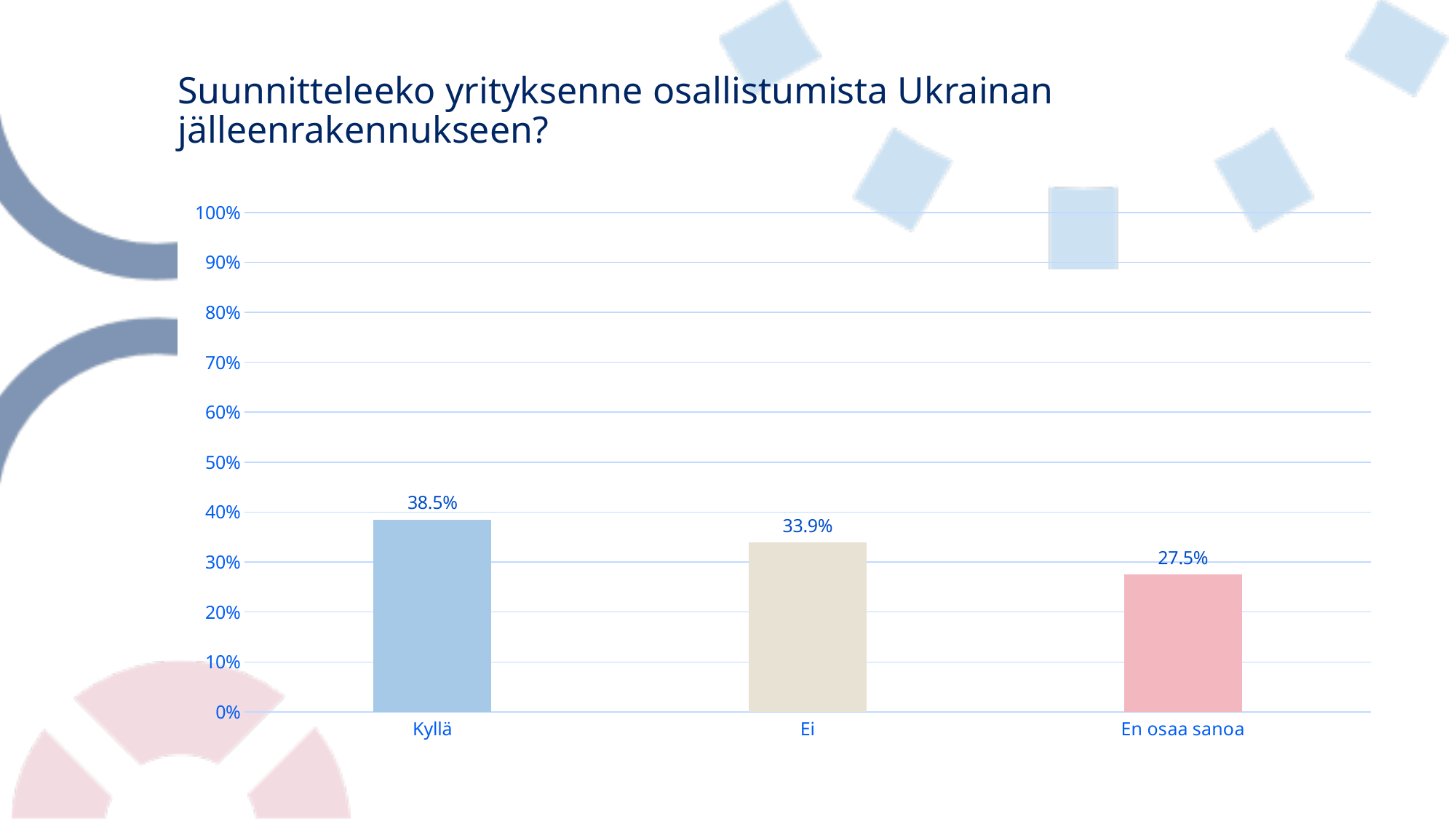
Which category has the highest value? Kyllä What is the difference between the values for Ei and En osaa sanoa? 6.4% What is the value for Kyllä? 38.5% Which category has the lowest value? En osaa sanoa Do the values rise or fall from left to right along the x axis? fall How many categories are shown on the x axis? 3 Is the value for Kyllä greater or less than 40%? less What is the value for En osaa sanoa? 27.5% What is the difference between the values for Kyllä and Ei? 4.6% What is the value for Ei? 33.9% What kind of chart is shown on the slide? bar chart Which is larger, the value for Ei or the value for En osaa sanoa? Ei